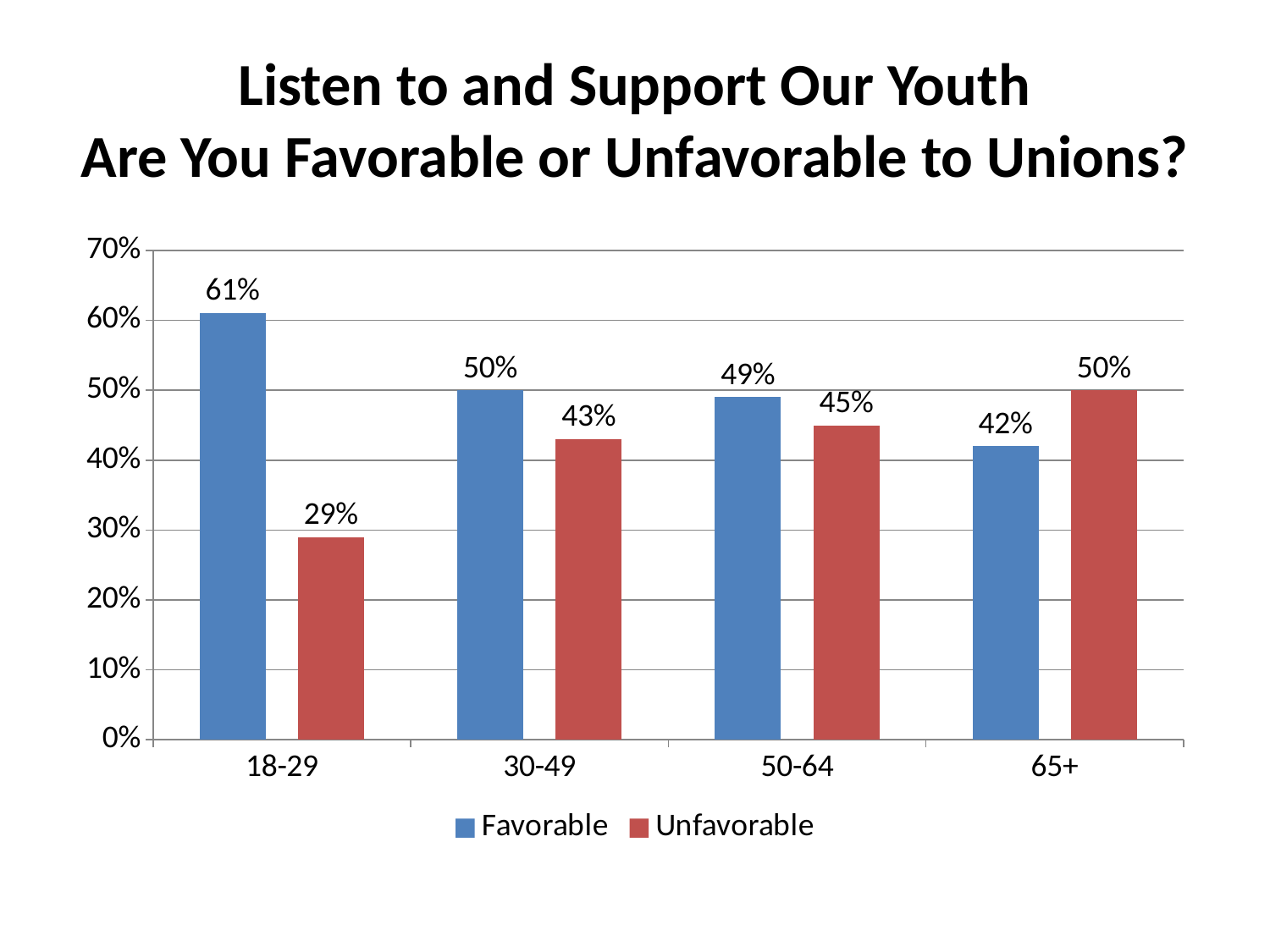
What is the Favorable value for the 18-29 age group? 61% What is the difference between the Favorable and Unfavorable values for the 18-29 age group? 32% How many age groups are shown on the x axis? 4 What is the Unfavorable value for the 65+ age group? 50% What is the Unfavorable value for the 30-49 age group? 43% How many series does the legend list? 2 What kind of chart is shown on the slide? Bar chart Which age group has the lowest Unfavorable value? 18-29 Which is larger for the 65+ age group, Favorable or Unfavorable? Unfavorable Which age group has the highest Favorable value? 18-29 What colour are the Unfavorable bars? Red Do the Favorable values rise or fall from the 18-29 group to the 65+ group? Fall